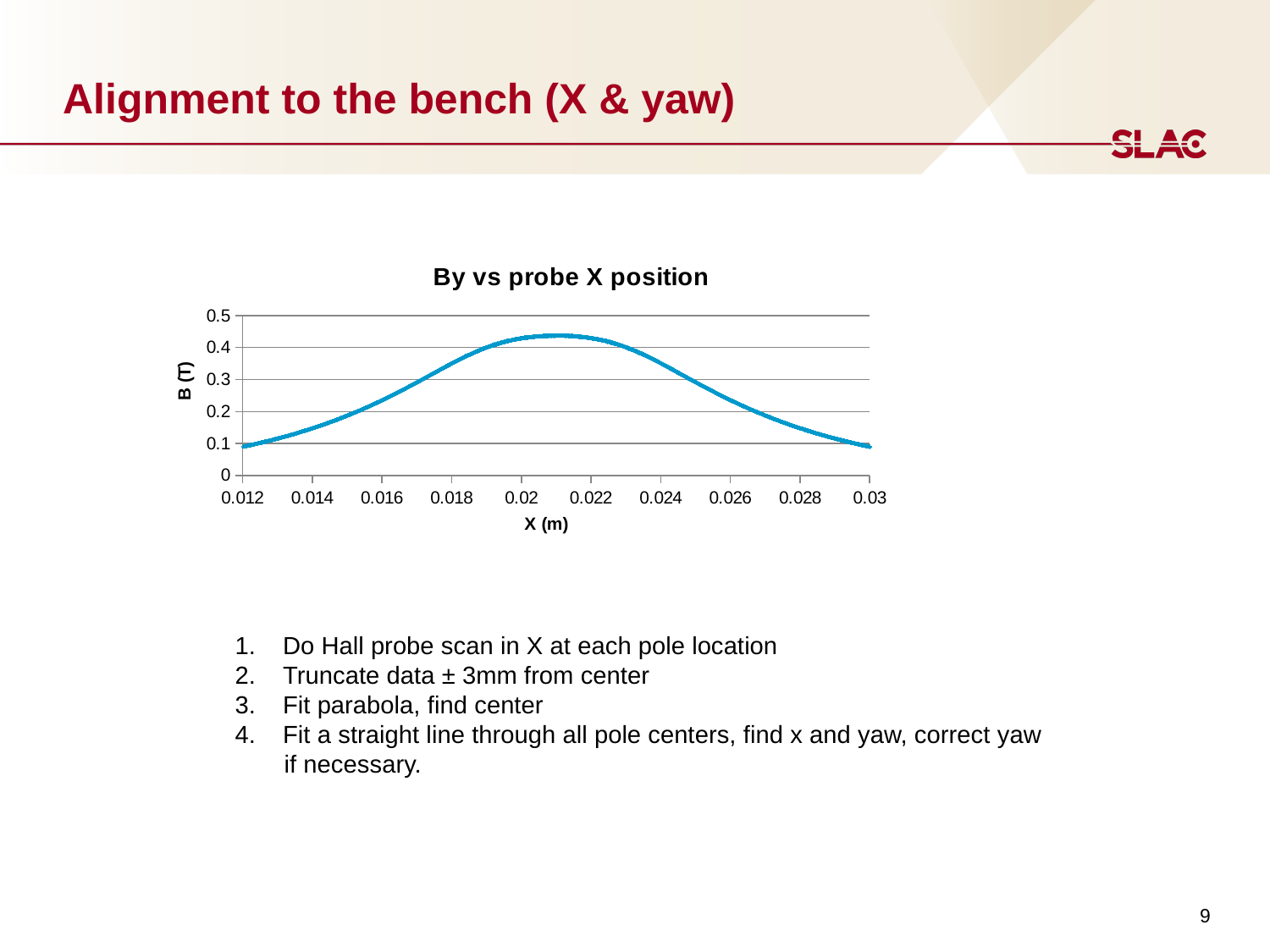
Which has the larger value of B: X = 0.014 or X = 0.024? X = 0.024 Is the value of B at X = 0.026 greater or less than 0.3? less Is the value of B at X = 0.021 greater or less than 0.4? greater Is the value of B at X = 0.03 greater or less than 0.2? less What kind of chart is shown on the slide? line chart Which has the larger value of B: X = 0.02 or X = 0.028? X = 0.02 What is the title of the chart? By vs probe X position Does the value of B rise or fall as X increases from 0.012 to 0.02? rise What is the label of the y axis of the chart? B (T) Does the value of B rise or fall as X increases from 0.022 to 0.03? fall